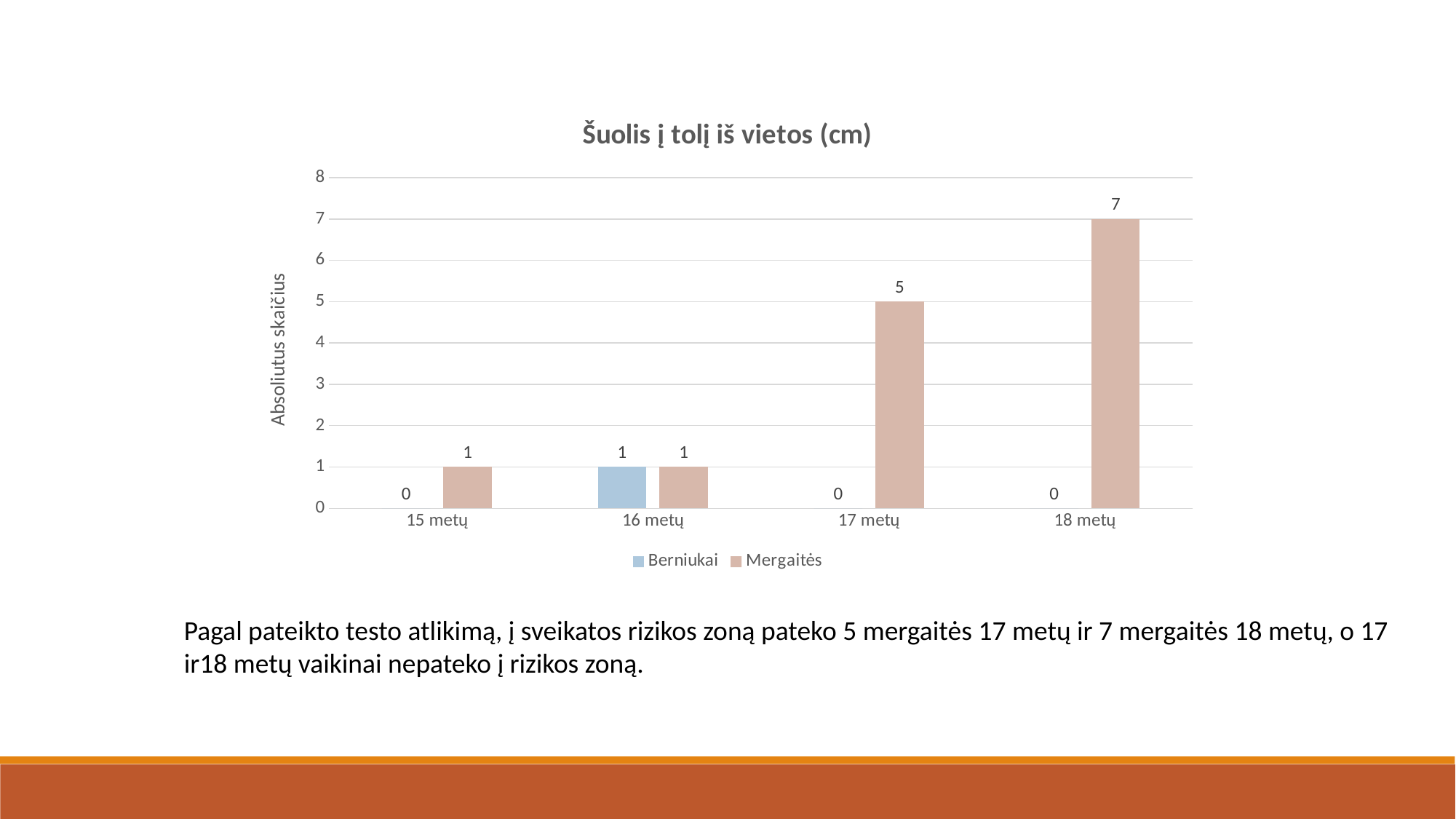
What kind of chart is shown on the slide? Bar chart What is the value for Berniukai at 15 metų? 0 Which is larger: the Mergaitės value at 17 metų or at 16 metų? 17 metų What is the title of the chart? Šuolis į tolį iš vietos (cm) Which age group has the highest value for Mergaitės? 18 metų What is the label of the vertical axis? Absoliutus skaičius What is the difference between the Mergaitės values for 18 metų and 17 metų? 2 What is the value for Berniukai at 16 metų? 1 How many series does the legend list? 2 What is the value for Mergaitės at 17 metų? 5 How many age categories are shown on the x axis? 4 What is the value for Mergaitės at 18 metų? 7